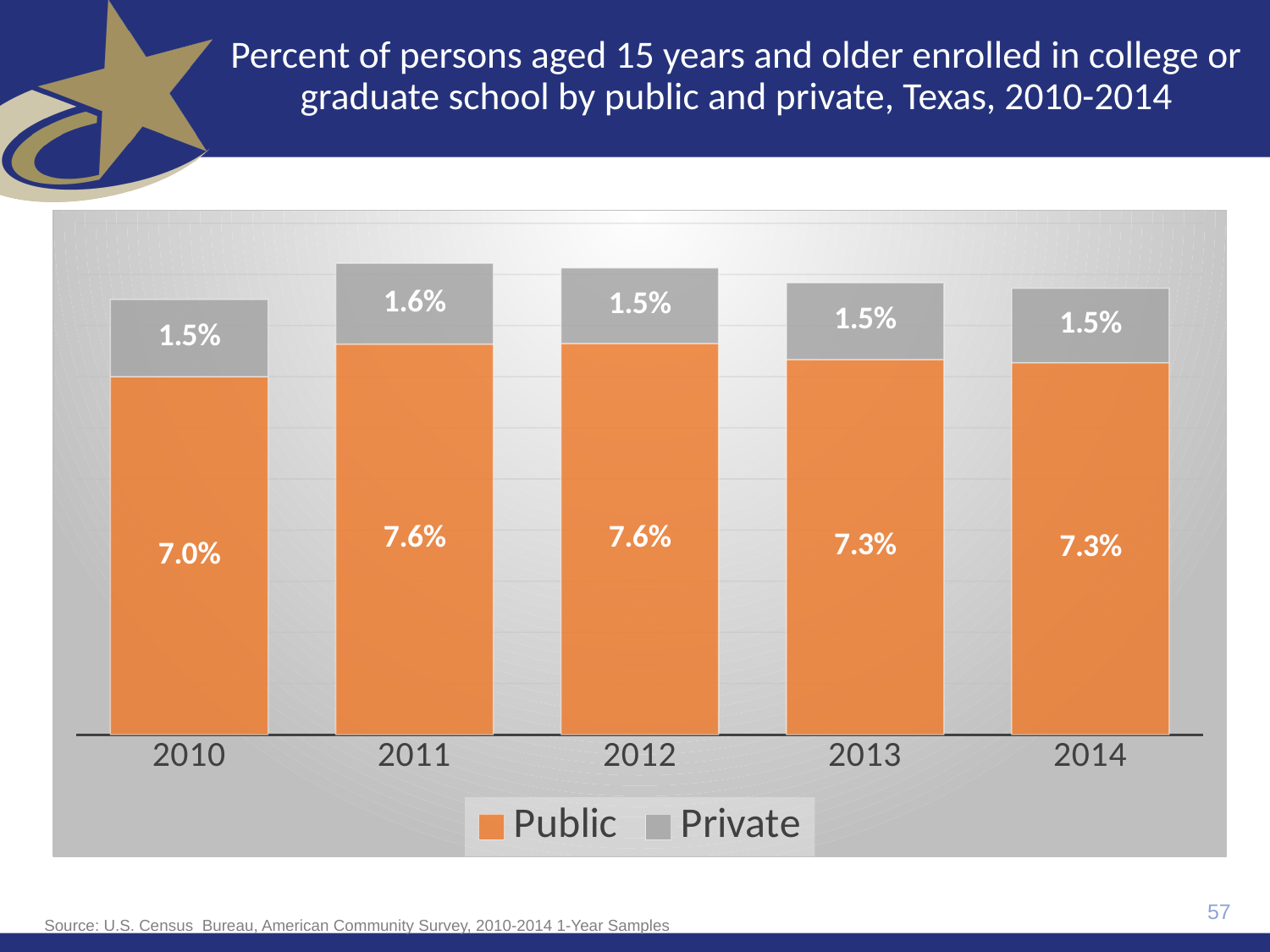
How many years are shown on the x axis? 5 Which year has the lowest Public value? 2010 What is the difference between the Public values for 2011 and 2010? 0.6% Is the Public value for 2012 larger than the Public value for 2013? Yes How many series does the legend list? 2 What is the Public value for 2010? 7.0% What is the total of the stacked bar for 2010? 8.5% What is the total of the stacked bar for 2011? 9.2% Which year has the highest Private value? 2011 What kind of chart is shown? Stacked bar chart What is the Private value for 2011? 1.6% What is the Public value for 2014? 7.3%